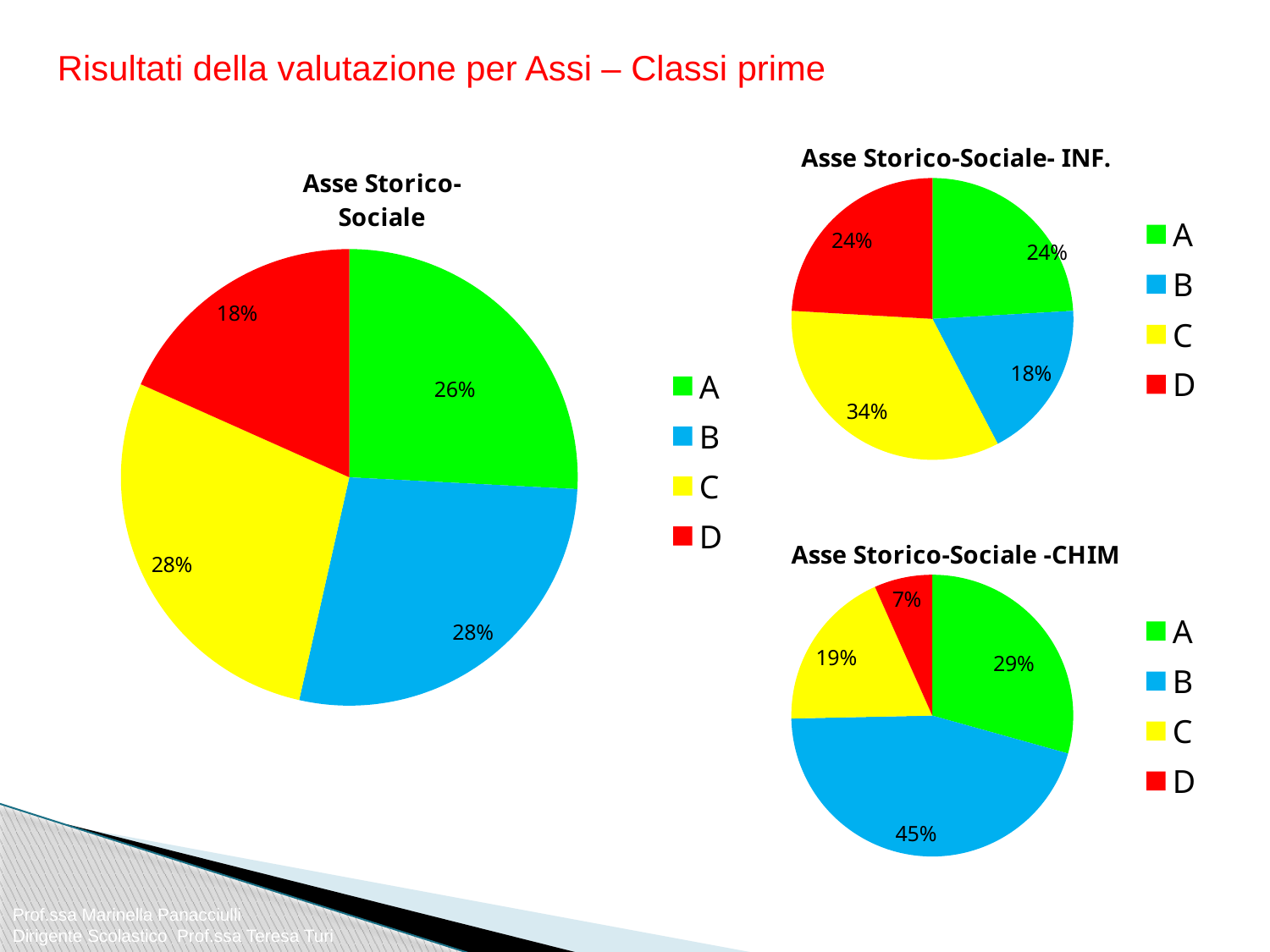
In the 'Asse Storico-Sociale -CHIM' pie chart, which category has the smallest slice? D In the 'Asse Storico-Sociale- INF.' pie chart, which is larger, the share of A or the share of B? A In the 'Asse Storico-Sociale' pie chart, what is the difference between the shares of B and D? 10% In the 'Asse Storico-Sociale' pie chart, which category has the smallest slice? D What type of chart is the 'Asse Storico-Sociale' chart? Pie chart In the 'Asse Storico-Sociale- INF.' pie chart, what colour is the slice for category D? Red In the 'Asse Storico-Sociale -CHIM' pie chart, what is the difference between the shares of A and C? 10% In the 'Asse Storico-Sociale' pie chart, what share does category A have? 26% In the 'Asse Storico-Sociale -CHIM' pie chart, what share does category B have? 45% How many categories does the legend of the 'Asse Storico-Sociale -CHIM' chart list? 4 In the 'Asse Storico-Sociale- INF.' pie chart, which category has the largest slice? C In the 'Asse Storico-Sociale- INF.' pie chart, what share does category C have? 34%